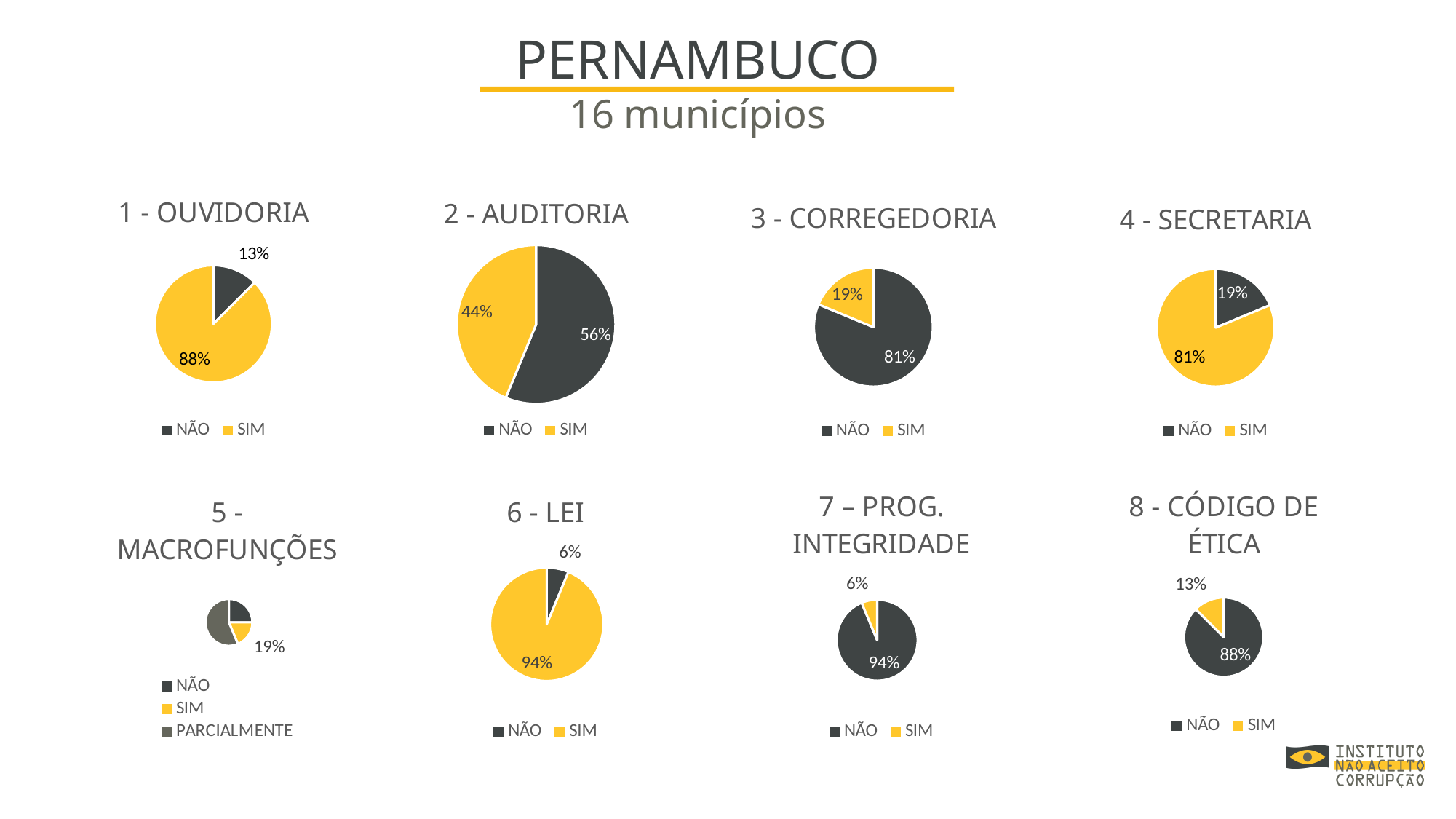
In the '2 - AUDITORIA' chart, what is the difference between the NÃO and SIM values? 12% In the '5 - MACROFUNÇÕES' chart, what is the value for SIM? 19% In the '8 - CÓDIGO DE ÉTICA' chart, what is the value for SIM? 13% In the '4 - SECRETARIA' chart, which slice is larger, NÃO or SIM? SIM In the '6 - LEI' chart, what is the value for NÃO? 6% In the '1 - OUVIDORIA' chart, what is the value for SIM? 88% How many pie charts are shown on the slide? 8 What kind of chart is used for '1 - OUVIDORIA'? Pie chart How many entries does the legend of the '5 - MACROFUNÇÕES' chart list? 3 In the '7 – PROG. INTEGRIDADE' chart, which category has the largest slice? NÃO In the '3 - CORREGEDORIA' chart, what is the value for SIM? 19% In the '2 - AUDITORIA' chart, what is the value for NÃO? 56%